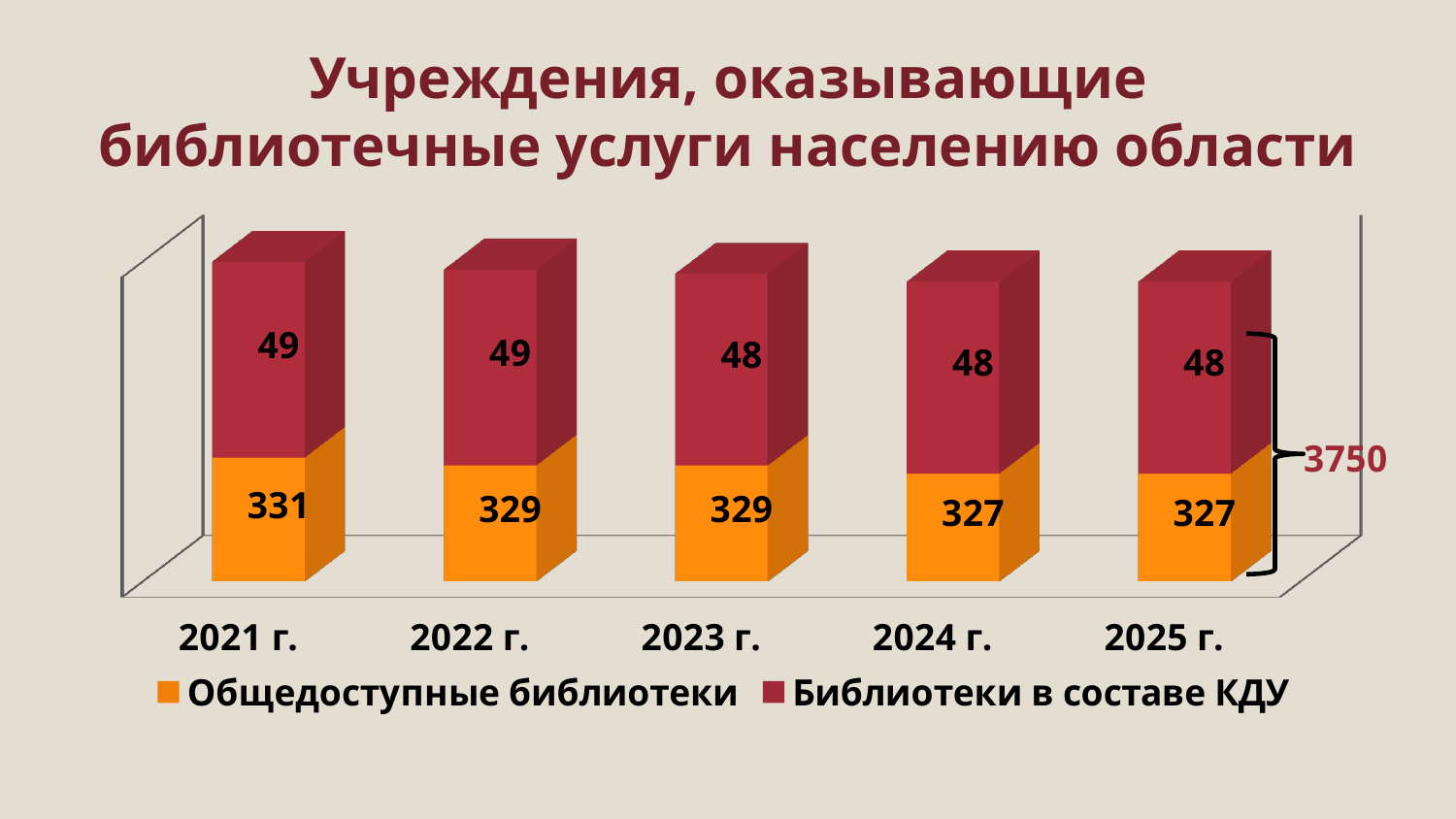
What is the value for Библиотеки в составе КДУ in 2023 г.? 48 What is the total of the stacked bar for 2021 г.? 380 What kind of chart is shown on the slide? Stacked bar chart Which is larger: the Общедоступные библиотеки value in 2022 г. or in 2024 г.? 2022 г. What is the value for Общедоступные библиотеки in 2021 г.? 331 Which year has the highest value for Общедоступные библиотеки? 2021 г. What is the difference between the Общедоступные библиотеки values for 2021 г. and 2025 г.? 4 Do the values for Общедоступные библиотеки rise or fall from 2021 г. to 2025 г.? Fall How many years are shown on the x axis? 5 How many series does the legend list? 2 Which colour represents Библиотеки в составе КДУ in the legend? Dark red What is the value for Общедоступные библиотеки in 2025 г.? 327